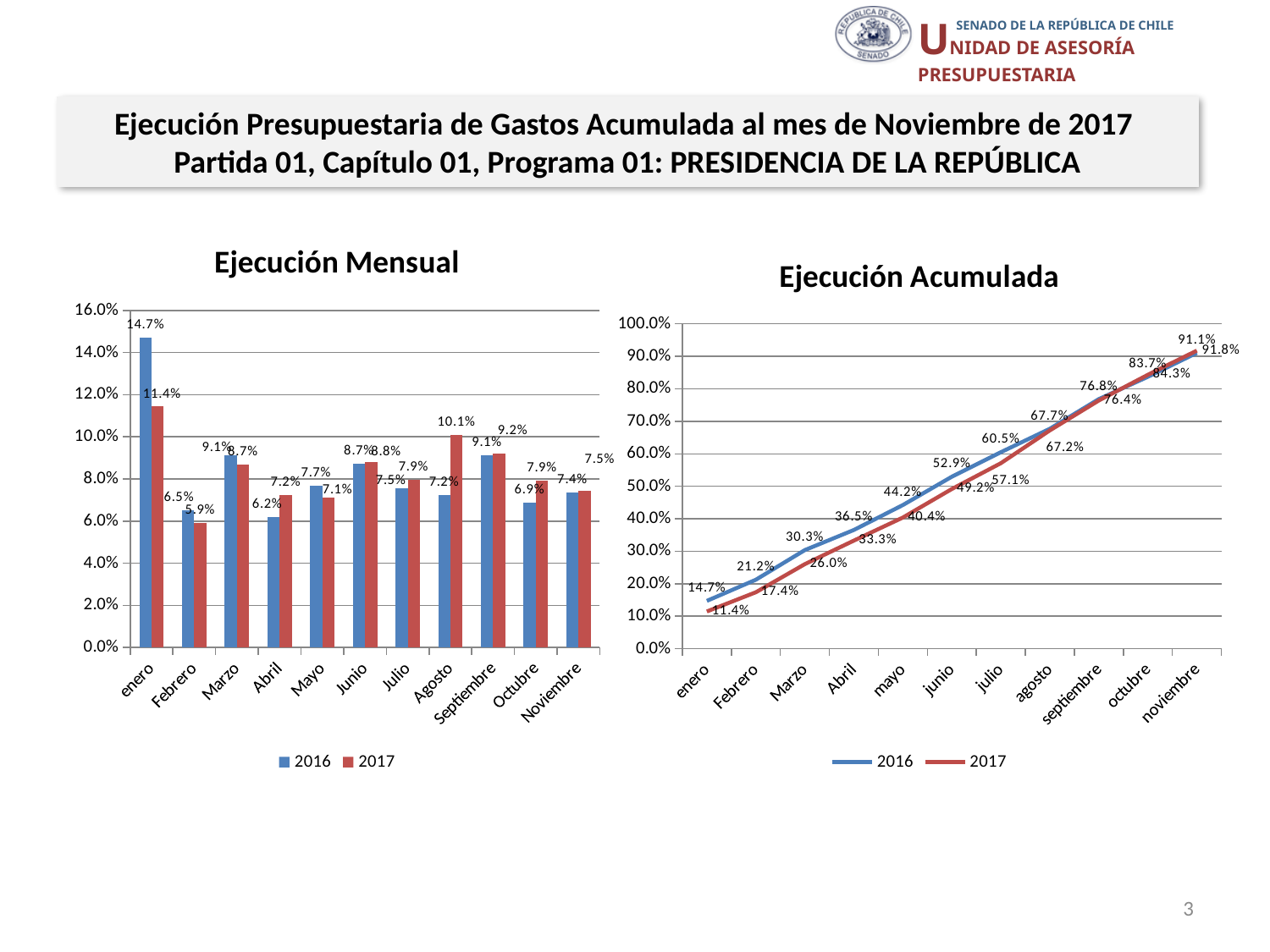
In the Ejecución Acumulada chart, what is the value for 2016 in junio? 52.9% In the Ejecución Mensual chart, which month has the lowest value for 2017? Febrero In the Ejecución Mensual chart, what is the value for 2016 in enero? 14.7% In the Ejecución Acumulada chart, what is the value for 2017 in noviembre? 91.8% In the Ejecución Mensual chart, which is larger in Abril, the 2016 value or the 2017 value? 2017 What kind of chart is the Ejecución Mensual chart? bar chart In the Ejecución Mensual chart, what is the difference between the 2016 and 2017 values in enero? 3.3% How many series does the legend of the Ejecución Acumulada chart list? 2 How many months are shown on the x axis of the Ejecución Acumulada chart? 11 In the Ejecución Mensual chart, what is the value for 2017 in Agosto? 10.1% In the Ejecución Acumulada chart, do the values for 2016 rise or fall from enero to noviembre? rise In the Ejecución Mensual chart, which month has the highest value for 2016? enero